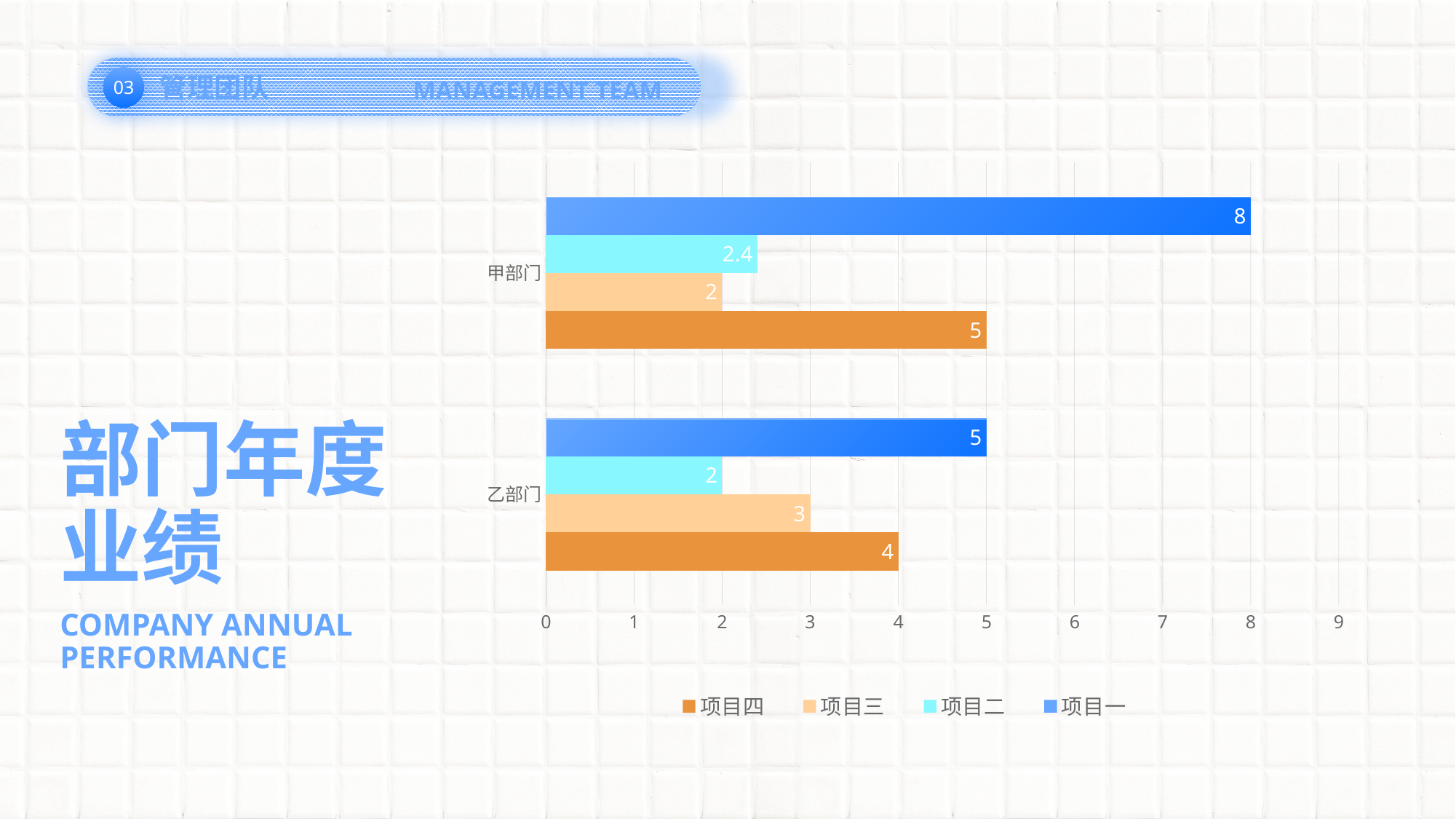
What is the total of the four series values for 乙部门? 14 What is the value of 项目二 for 甲部门? 2.4 Which series has the highest value for 甲部门? 项目一 What is the difference between 项目一 for 甲部门 and 项目一 for 乙部门? 3 What is the value of 项目三 for 乙部门? 3 Which is larger: 项目四 for 甲部门 or 项目四 for 乙部门? 甲部门 How many series does the legend list? 4 What is the value of 项目一 for 甲部门? 8 What is the value of 项目四 for 乙部门? 4 How many categories (departments) are shown on the chart? 2 What kind of chart is shown on the slide? Bar chart Which series has the lowest value for 乙部门? 项目二